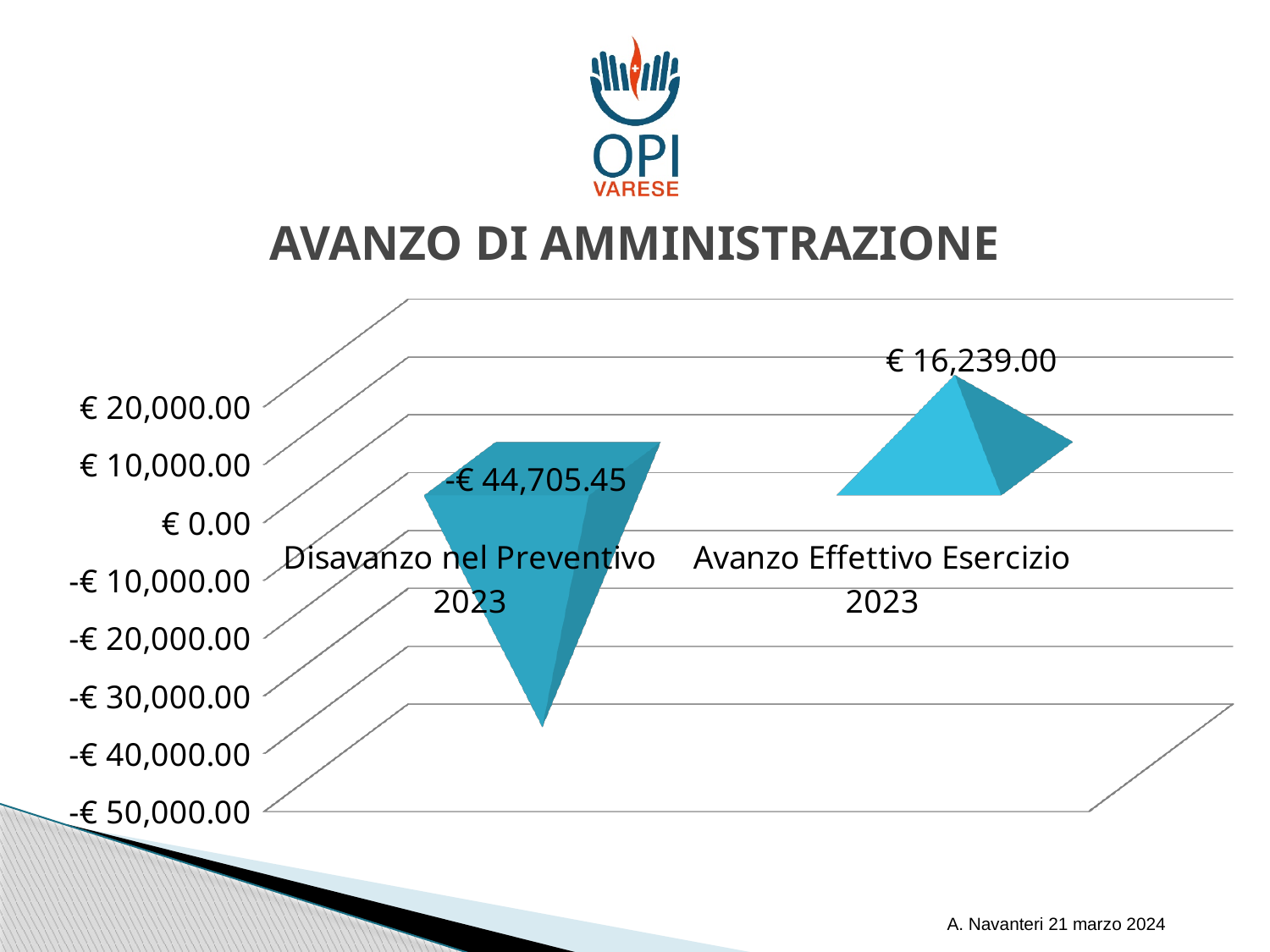
Which is larger, the value for Disavanzo nel Preventivo 2023 or the value for Avanzo Effettivo Esercizio 2023? Avanzo Effettivo Esercizio 2023 Which category has the lowest value? Disavanzo nel Preventivo 2023 What is the title of the chart? AVANZO DI AMMINISTRAZIONE Is the value for Disavanzo nel Preventivo 2023 greater or less than -€ 40,000.00? less How many categories are shown in the chart? 2 Is the value for Avanzo Effettivo Esercizio 2023 greater or less than € 10,000.00? greater Which category has the highest value? Avanzo Effettivo Esercizio 2023 What kind of chart is shown on the slide? bar chart What is the value for Disavanzo nel Preventivo 2023? -€ 44,705.45 What is the lowest value shown on the vertical axis? -€ 50,000.00 What is the difference between the value for Avanzo Effettivo Esercizio 2023 and the value for Disavanzo nel Preventivo 2023? € 60,944.45 What is the value for Avanzo Effettivo Esercizio 2023? € 16,239.00